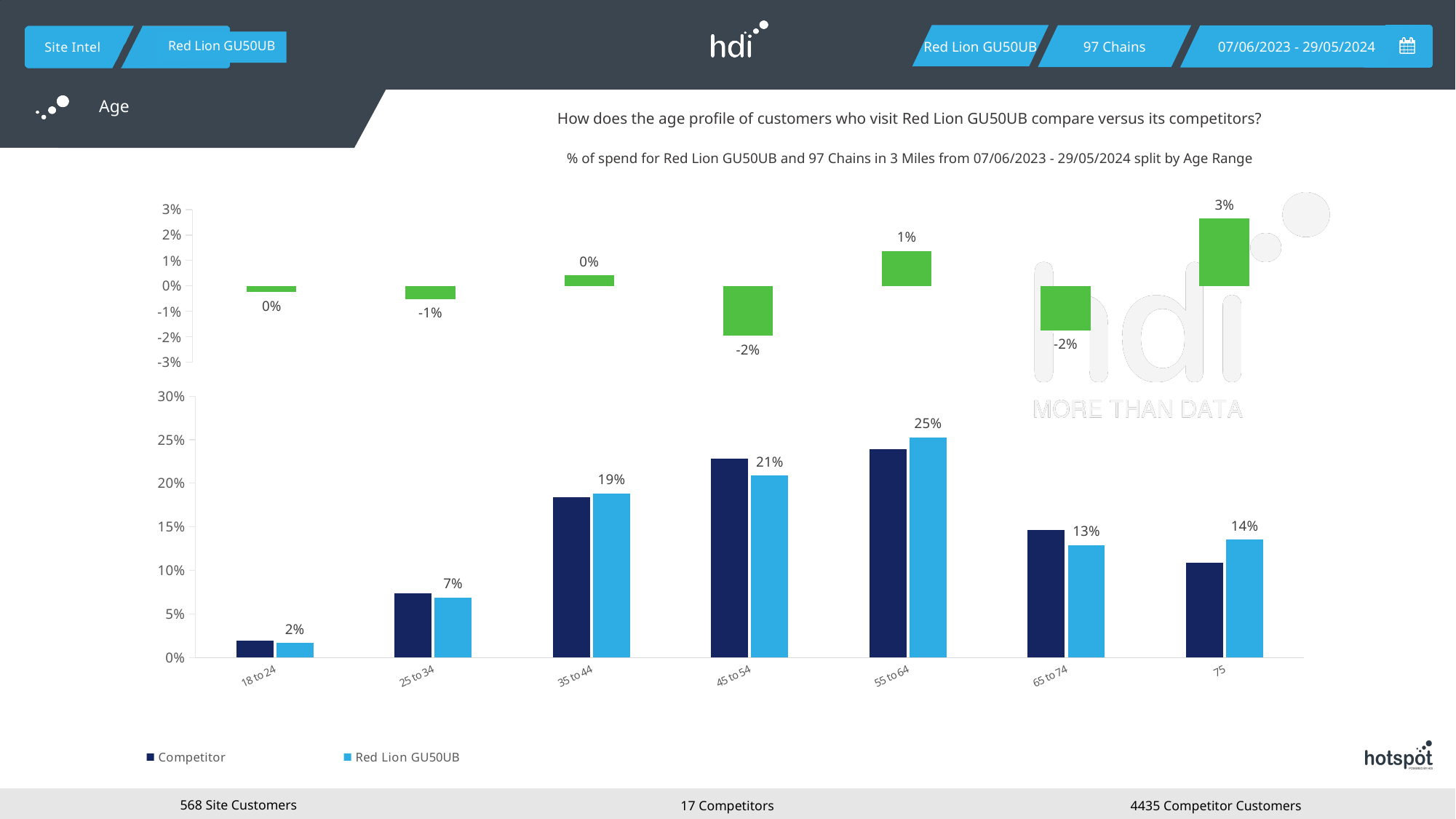
In the bottom chart, for the 75 age range, which is larger: the Competitor bar or the Red Lion GU50UB bar? Red Lion GU50UB In the bottom chart, which age range has the highest value for Red Lion GU50UB? 55 to 64 In the bottom chart, which age range has the lowest value for Red Lion GU50UB? 18 to 24 How many age range categories are shown on the x axis of the bottom chart? 7 In the bottom chart, is the Competitor value for 45 to 54 greater or less than 20%? greater In the bottom chart, what is the difference between the Red Lion GU50UB values for 55 to 64 and 45 to 54? 4% How many series does the legend of the bottom chart list? 2 In the bottom chart, what is the value for Red Lion GU50UB in the 55 to 64 age range? 25% What kind of chart is the bottom chart? bar chart In the top chart, which age range has the lowest value? 45 to 54 and 65 to 74 In the bottom chart, what is the value for Red Lion GU50UB in the 18 to 24 age range? 2% In the top chart, what is the value shown for the 75 age range? 3%